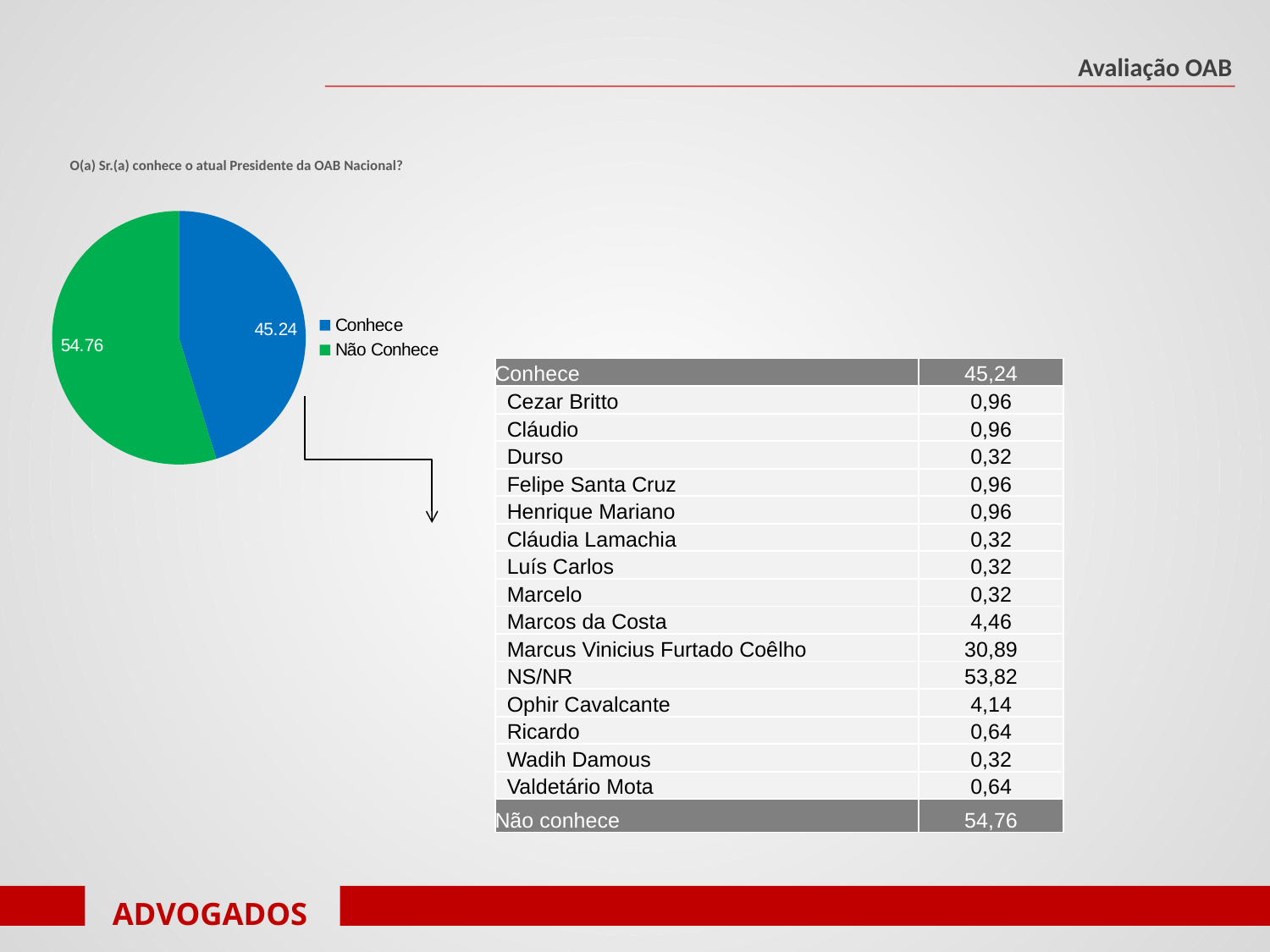
What is the difference between the Não Conhece and Conhece values in the pie chart? 9.52 Which slice of the pie chart is the smallest? Conhece Which slice of the pie chart is the largest? Não Conhece What kind of chart is shown on the slide? pie chart How many slices does the pie chart have? 2 What is the value of the Conhece slice in the pie chart? 45.24 What colour is the Não Conhece slice in the pie chart? green How many entries does the pie chart legend list? 2 What is the value of the Não Conhece slice in the pie chart? 54.76 Is the value of the Conhece slice in the pie chart greater or less than 50? less What colour is the Conhece slice in the pie chart? blue Which is larger in the pie chart, Conhece or Não Conhece? Não Conhece